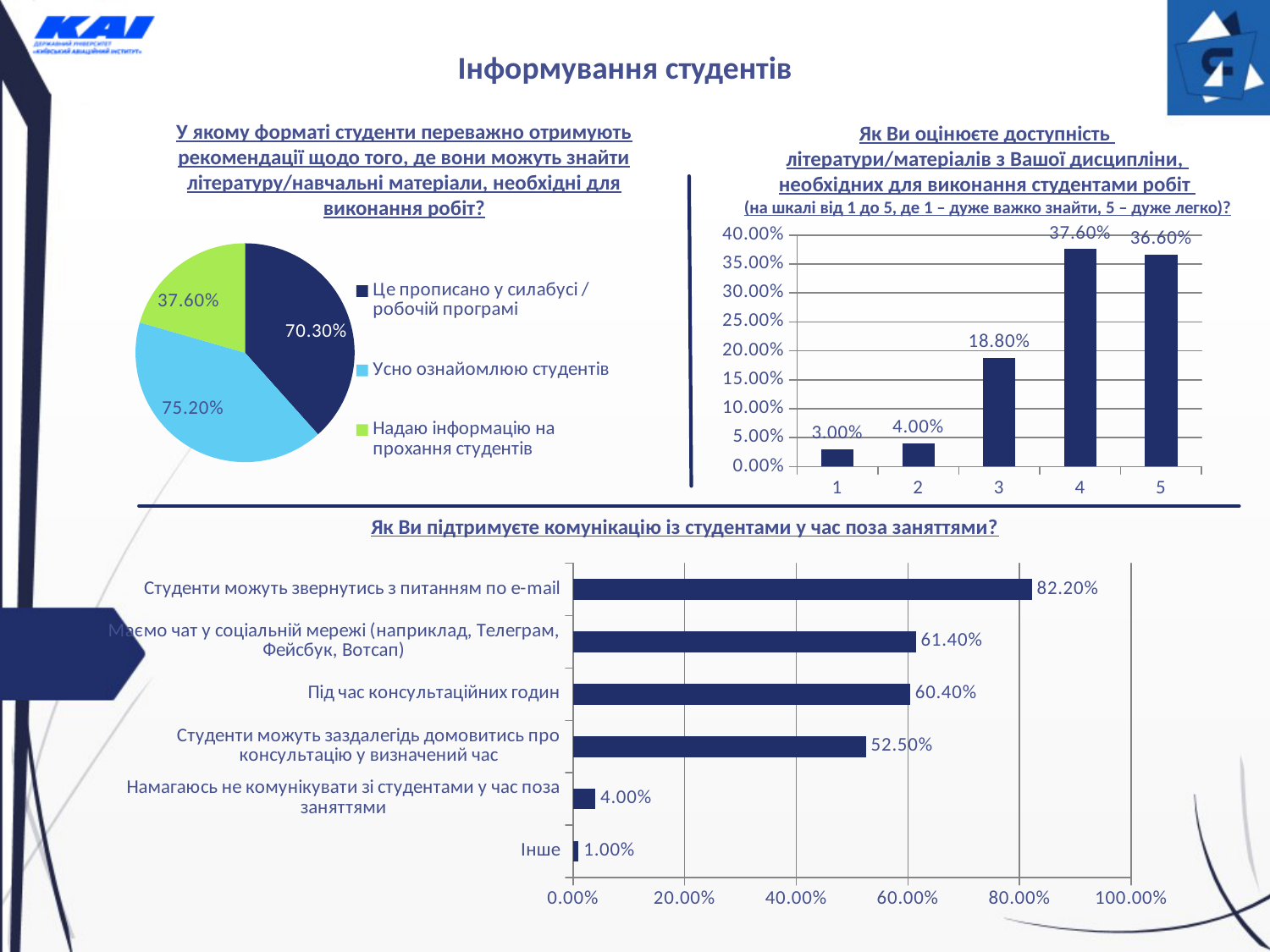
In the top-right bar chart (Як Ви оцінюєте доступність літератури/матеріалів), what is the difference between the values for rating 4 and rating 5? 1.00% In the top-right bar chart (Як Ви оцінюєте доступність літератури/матеріалів), which rating has the lowest value? 1 In the bottom chart (Як Ви підтримуєте комунікацію із студентами у час поза заняттями), what is the difference between the values for e-mail and 'Інше'? 81.20% In the top-right bar chart (Як Ви оцінюєте доступність літератури/матеріалів), what is the value for rating 3? 18.80% What kind of chart is the bottom chart (Як Ви підтримуєте комунікацію із студентами у час поза заняттями)? Bar chart In the bottom chart (Як Ви підтримуєте комунікацію із студентами у час поза заняттями), what is the value for 'Під час консультаційних годин'? 60.40% In the pie chart on the top left, how many categories does the legend list? 3 In the pie chart on the top left, which category has the smallest value? Надаю інформацію на прохання студентів In the top-right bar chart (Як Ви оцінюєте доступність літератури/матеріалів), how many rating categories are shown on the x axis? 5 In the bottom chart (Як Ви підтримуєте комунікацію із студентами у час поза заняттями), which category has the highest value? Студенти можуть звернутись з питанням по e-mail In the pie chart on the top left, what is the value for 'Усно ознайомлюю студентів'? 75.20% In the top-right bar chart (Як Ви оцінюєте доступність літератури/матеріалів), which rating has the highest value? 4